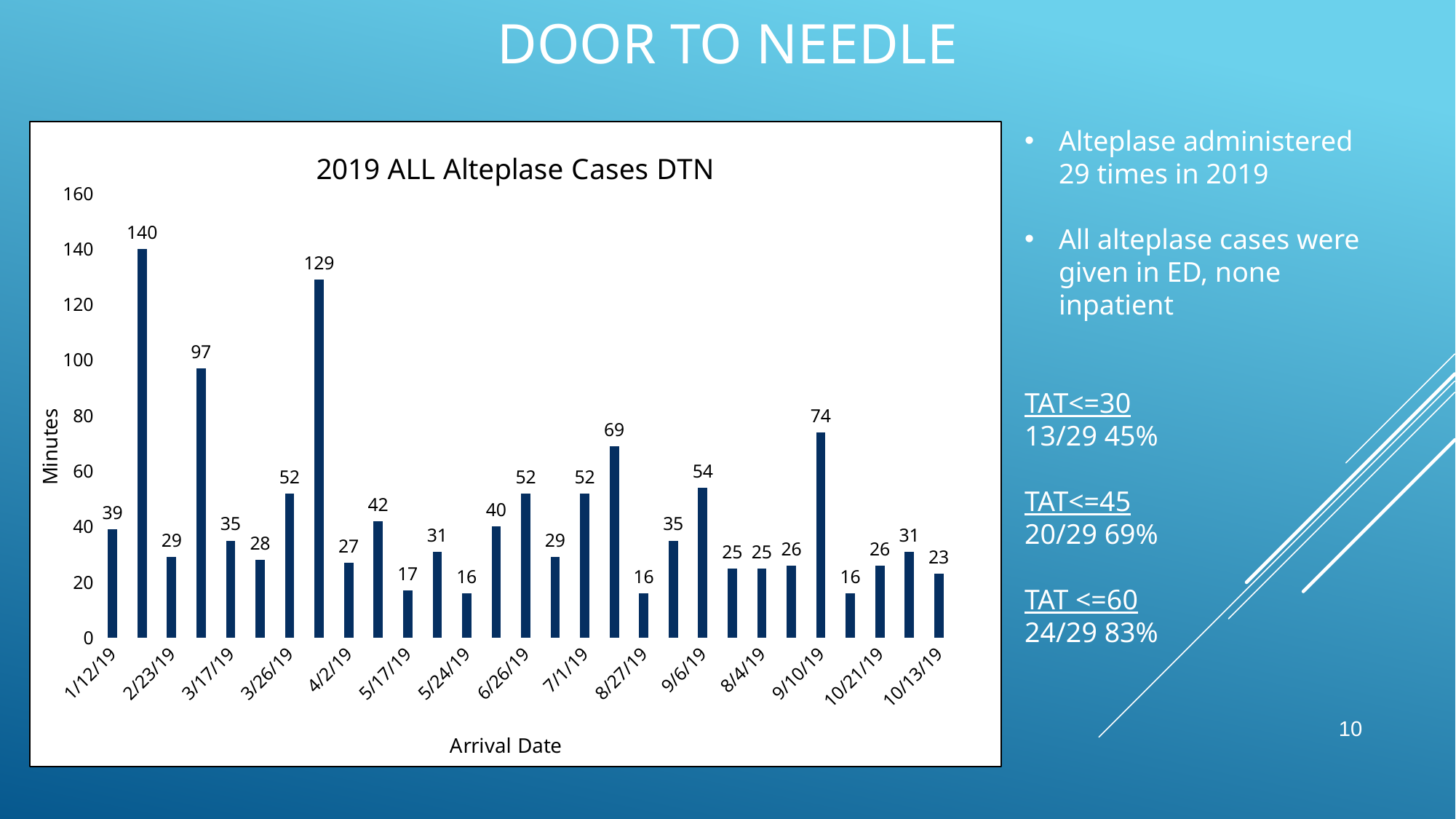
What is the value for the last bar, labelled 10/13/19? 23 What is the difference between the two highest values in the chart, 140 and 129? 11 What is the lowest value shown in the chart? 16 Which is larger, the bar labelled 140 or the bar labelled 129? 140 What is the second-highest value shown in the chart? 129 What is the label of the y axis? Minutes What is the highest value shown in the chart? 140 What type of chart is shown on the slide? bar chart What is the value for the first bar, labelled 1/12/19? 39 What is the title of the chart? 2019 ALL Alteplase Cases DTN Is the value of the bar labelled 97 greater or less than 80? greater